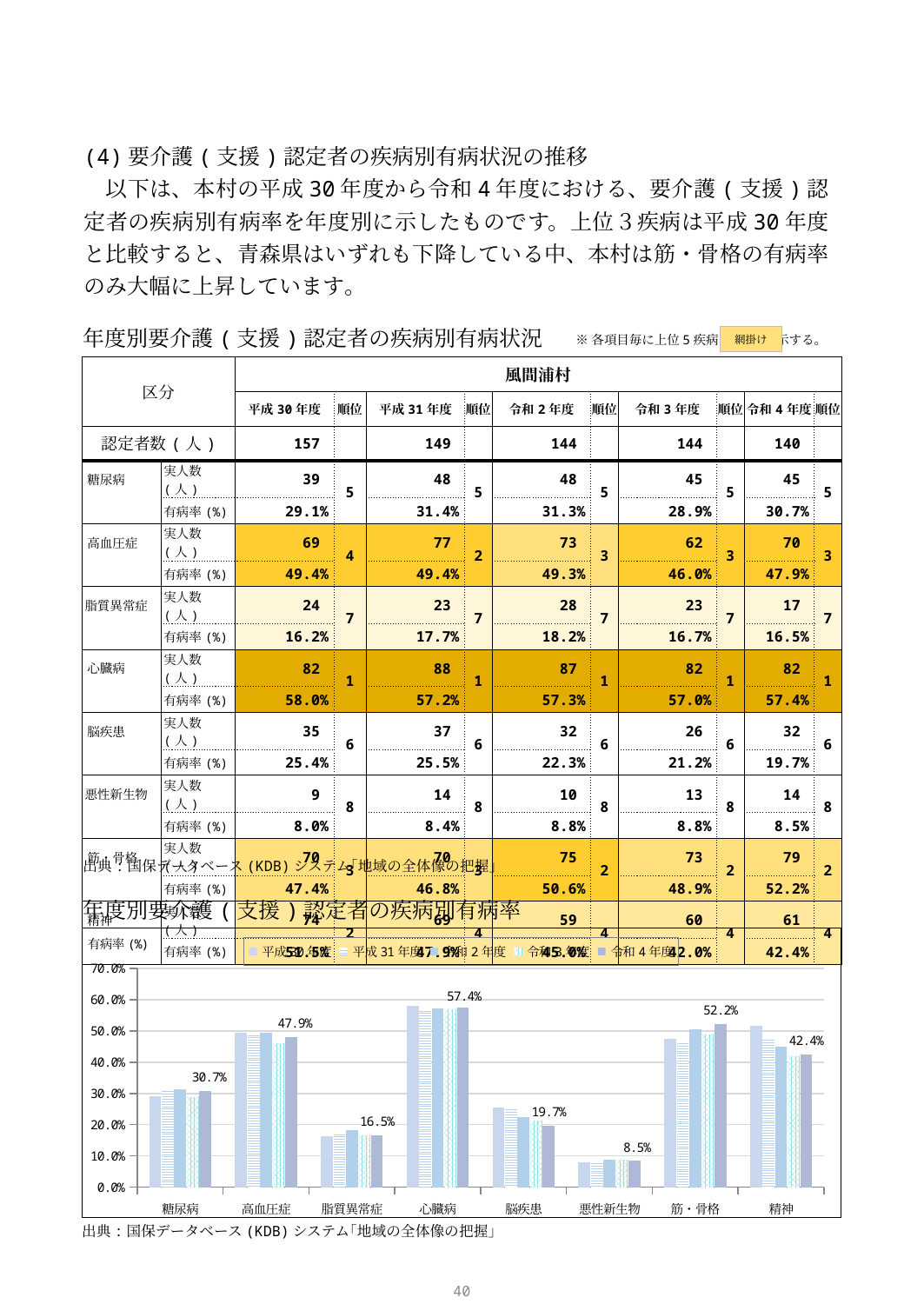
In the bar chart, which has the larger 令和4年度 value, 高血圧症 or 筋・骨格? 筋・骨格 In the bar chart, which disease category has the highest 令和4年度 value? 心臓病 In the bar chart, what is the 令和4年度 value for 筋・骨格? 52.2% In the bar chart, is the 平成30年度 value for 心臓病 greater or less than 50.0%? greater What is the title of the bar chart? 年度別要介護（支援）認定者の疾病別有病率 In the bar chart, which disease category has the lowest 令和4年度 value? 悪性新生物 In the bar chart, what is the difference between the 令和4年度 values for 心臓病 and 筋・骨格? 5.2% How many disease categories are shown on the x axis of the bar chart? 8 In the bar chart, what is the 令和4年度 value for 心臓病? 57.4% In the bar chart, what is the 令和4年度 value for 悪性新生物? 8.5% What kind of chart is shown at the bottom of the slide? bar chart How many series does the legend of the bar chart list? 5